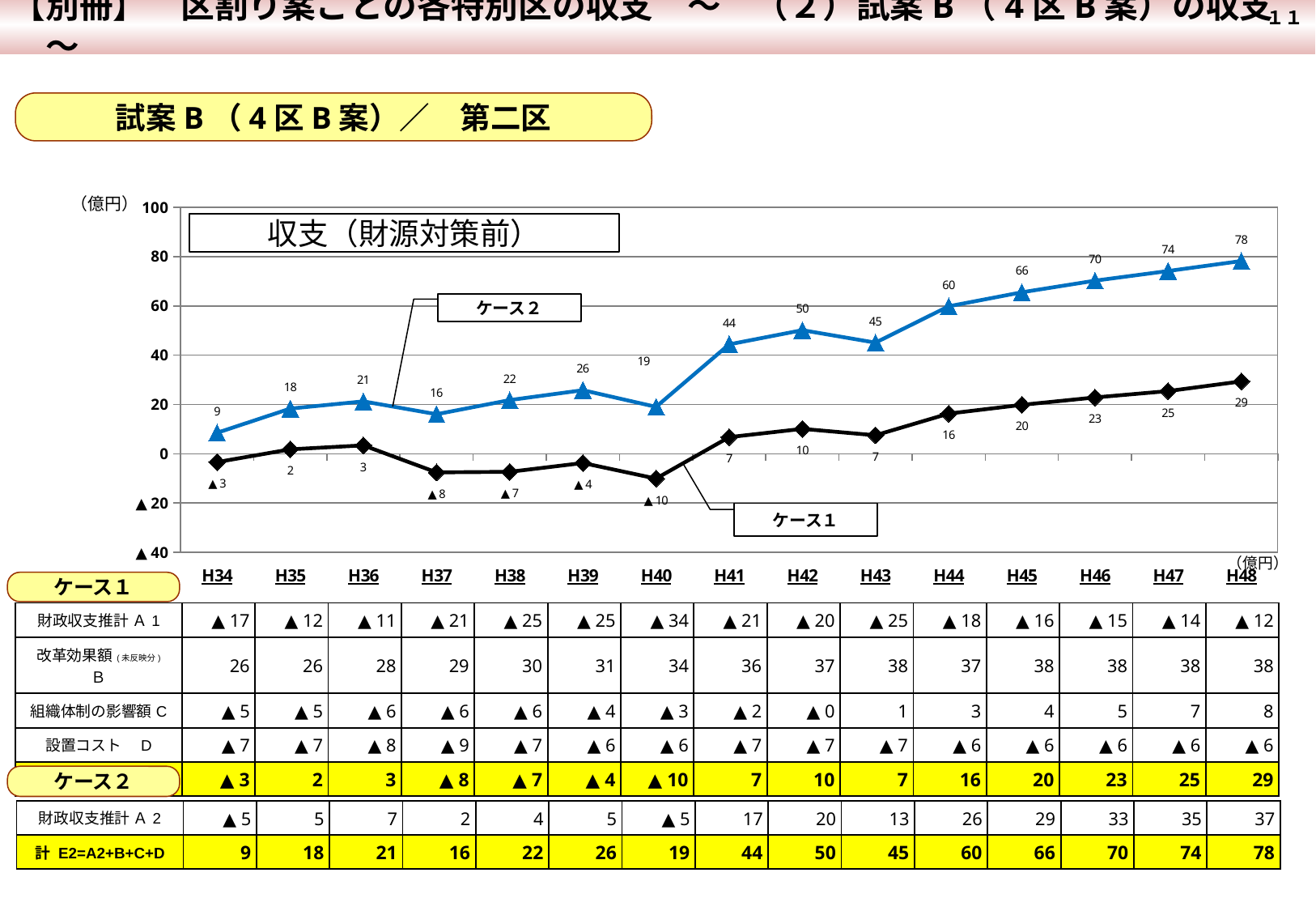
At which year does ケース2 reach its highest value? H48 Is the value of ケース2 at H45 greater or less than 60? greater How many series are plotted in the chart? 2 What is the difference between ケース2 and ケース1 at H44? 44 What type of chart is shown on the slide? line chart What is the value of ケース2 at H42 in the 収支（財源対策前） chart? 50 What is the value of ケース2 at H48? 78 Which is larger at H41: ケース2 or ケース1? ケース2 What is the title of the chart? 収支（財源対策前） What is the value of ケース1 at H40 in the chart? ▲10 At which year is ケース1 at its lowest value? H40 How many years are plotted on the x axis of the chart? 15